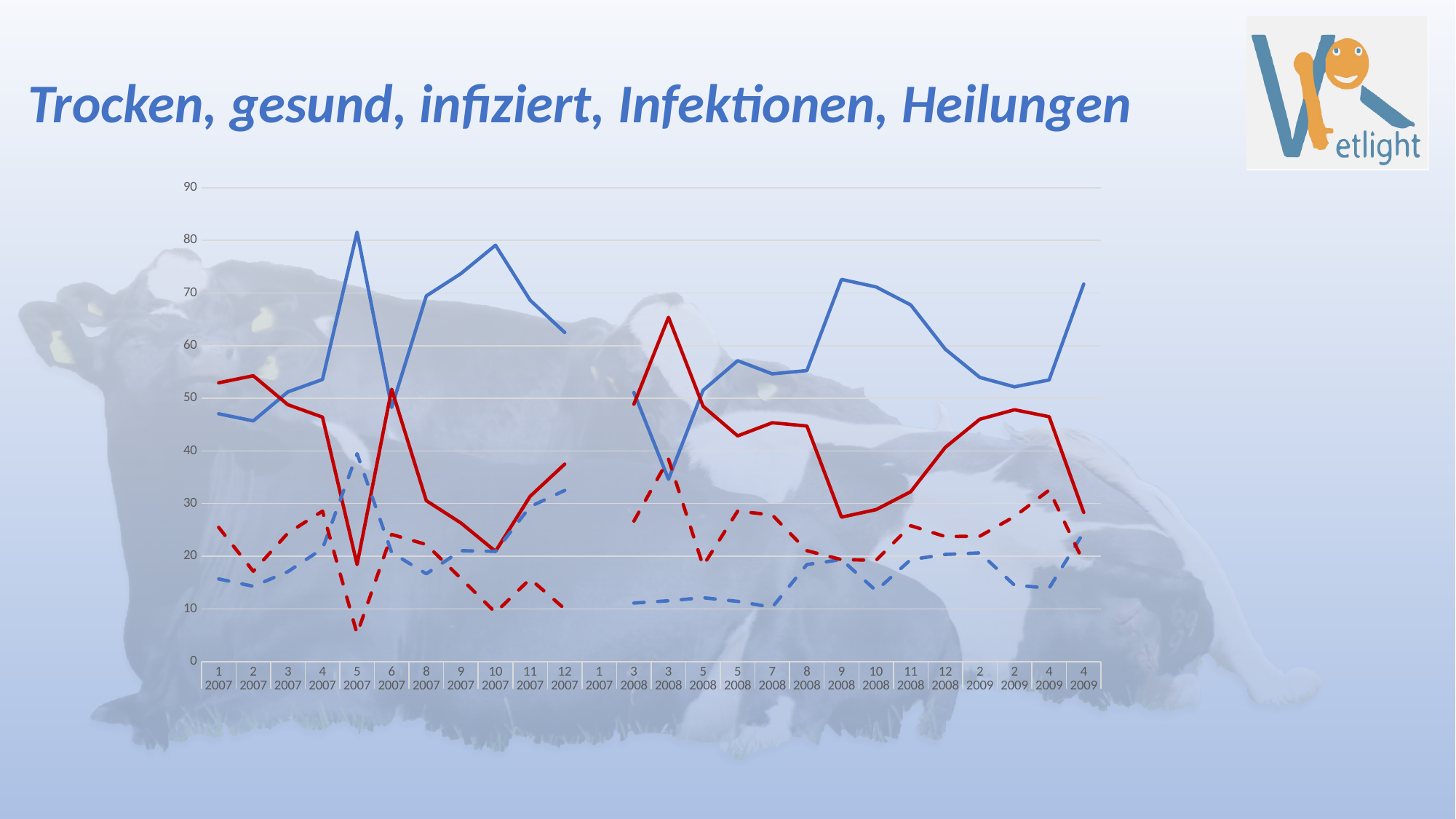
What is the title of the slide containing the chart? Trocken, gesund, infiziert, Infektionen, Heilungen At which x-axis category does the solid blue line reach its highest point? 5 2007 How many lines are plotted on the chart? 4 At 10 2007, which line has the larger value, the solid blue line or the solid red line? solid blue line Is the value of the dashed red line at 5 2007 greater or less than 10? less At which x-axis category does the dashed red line reach its lowest point? 5 2007 What is the highest value shown on the y axis of the chart? 90 Is the value of the solid blue line at 10 2007 greater or less than 70? greater What kind of chart is shown on the slide? line chart Does the solid blue line rise or fall between 6 2007 and 10 2007? rise Is the value of the solid red line at 4 2009 (the last category) greater or less than 40? less How many categories are shown on the x axis of the chart? 26